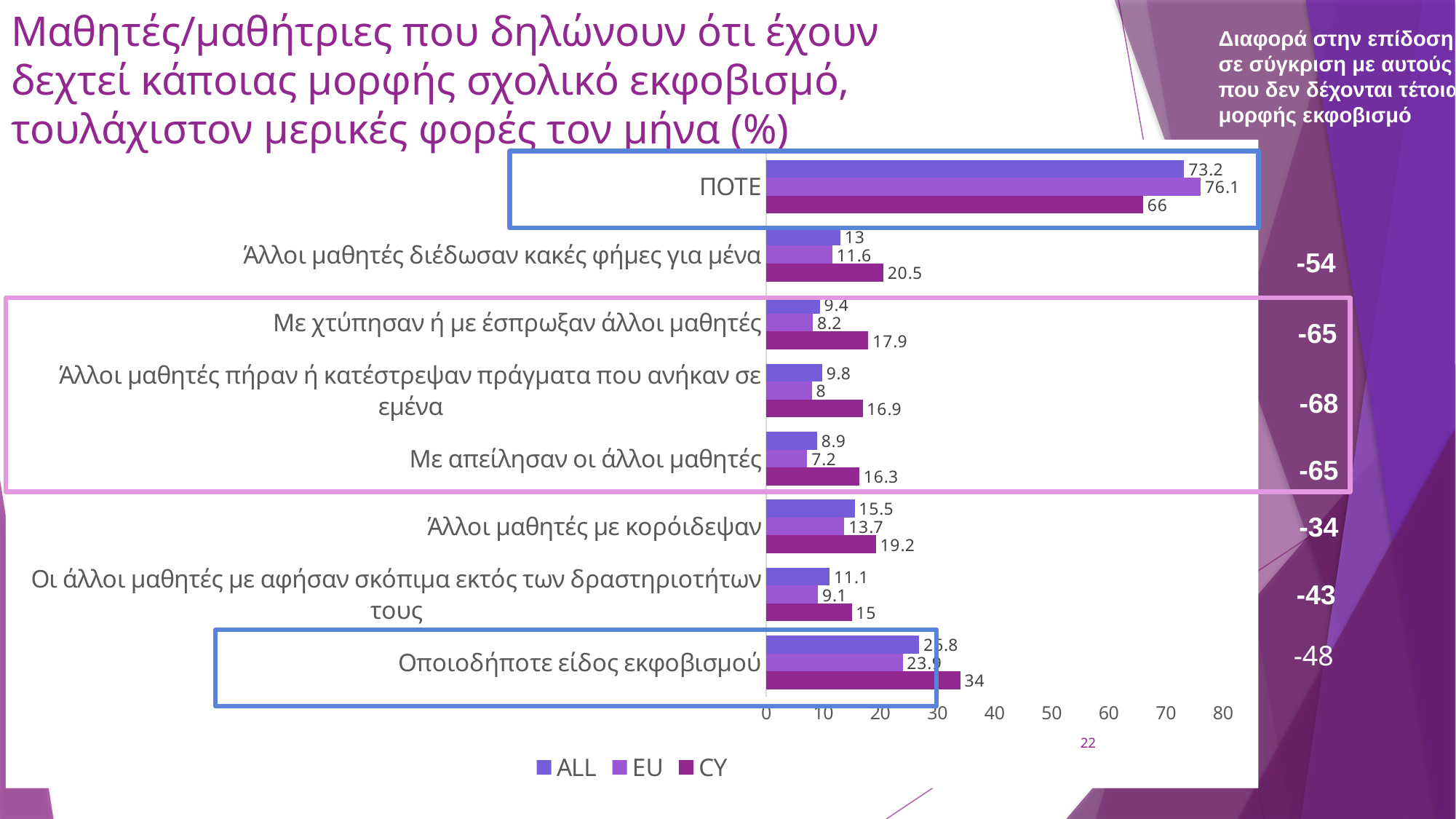
Which series is shown in the darkest purple colour in the legend? CY What is the CY value for 'Άλλοι μαθητές διέδωσαν κακές φήμες για μένα'? 20.5 How many series does the chart legend list? 3 What is the ALL value for 'Με απείλησαν οι άλλοι μαθητές'? 8.9 Which category has the highest CY value? ΠΟΤΕ What is the EU value for ΠΟΤΕ? 76.1 What type of chart is shown on the slide? bar chart What is the difference between the CY and EU values for 'Με χτύπησαν ή με έσπρωξαν άλλοι μαθητές'? 9.7 For 'Άλλοι μαθητές με κορόιδεψαν', which is larger, the ALL value or the CY value? CY What is the CY value for 'Οποιοδήποτε είδος εκφοβισμού'? 34 How many categories are shown on the chart? 8 Which category has the lowest EU value? Με απείλησαν οι άλλοι μαθητές